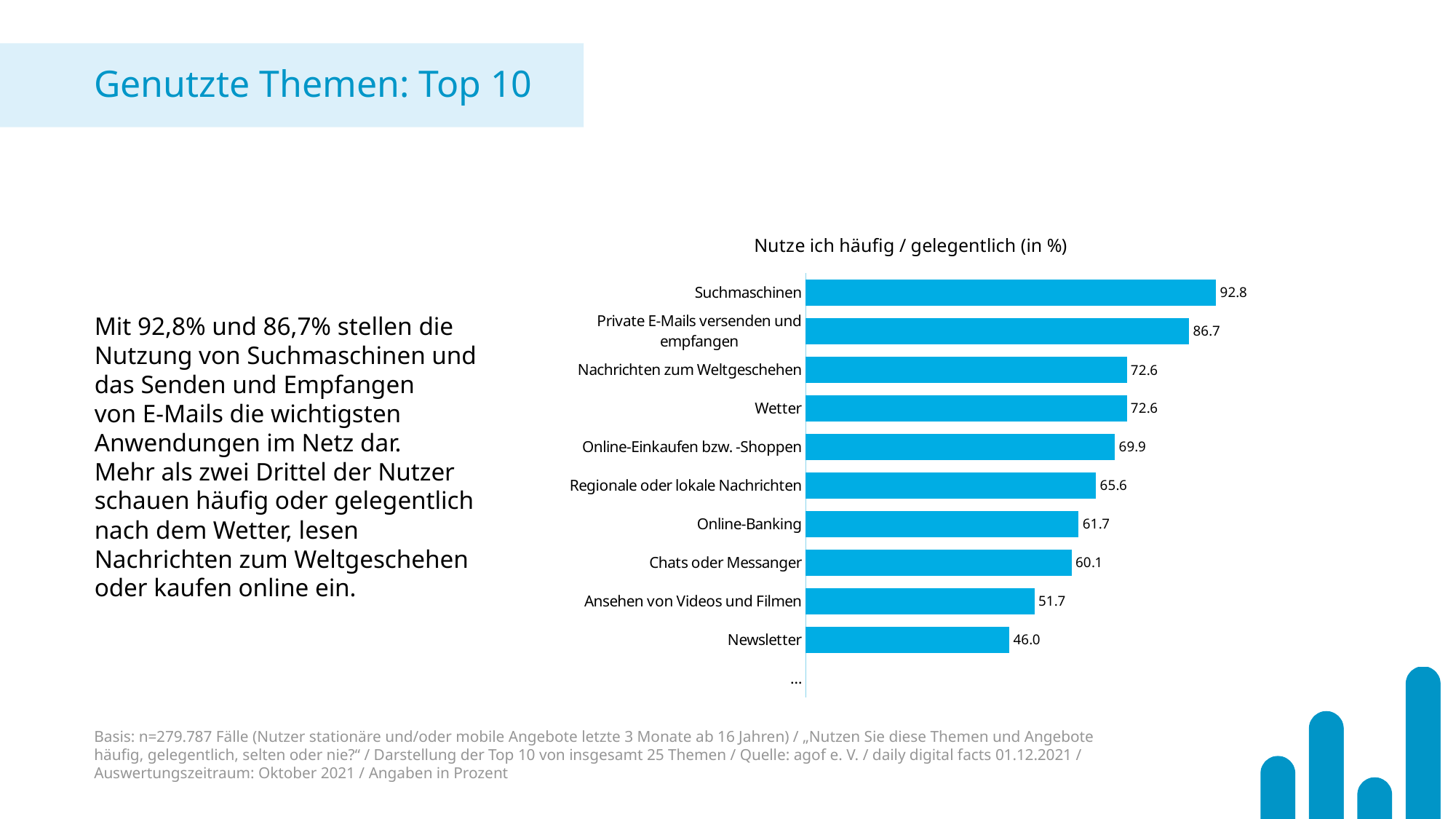
Which is larger, the value for Chats oder Messanger or the value for Ansehen von Videos und Filmen? Chats oder Messanger What kind of chart is shown on the slide? Bar chart How many labelled categories with bars are shown in the chart? 10 What is the value for Online-Banking? 61.7 What is the difference between the values for Online-Einkaufen bzw. -Shoppen and Newsletter? 23.9 What is the difference between the values for Suchmaschinen and Private E-Mails versenden und empfangen? 6.1 What is the value for Newsletter? 46.0 Which category has the highest value? Suchmaschinen What is the value for Suchmaschinen? 92.8 What is the title of the chart? Nutze ich häufig / gelegentlich (in %) Which labelled category has the lowest value? Newsletter Which is larger, the value for Regionale oder lokale Nachrichten or the value for Online-Banking? Regionale oder lokale Nachrichten